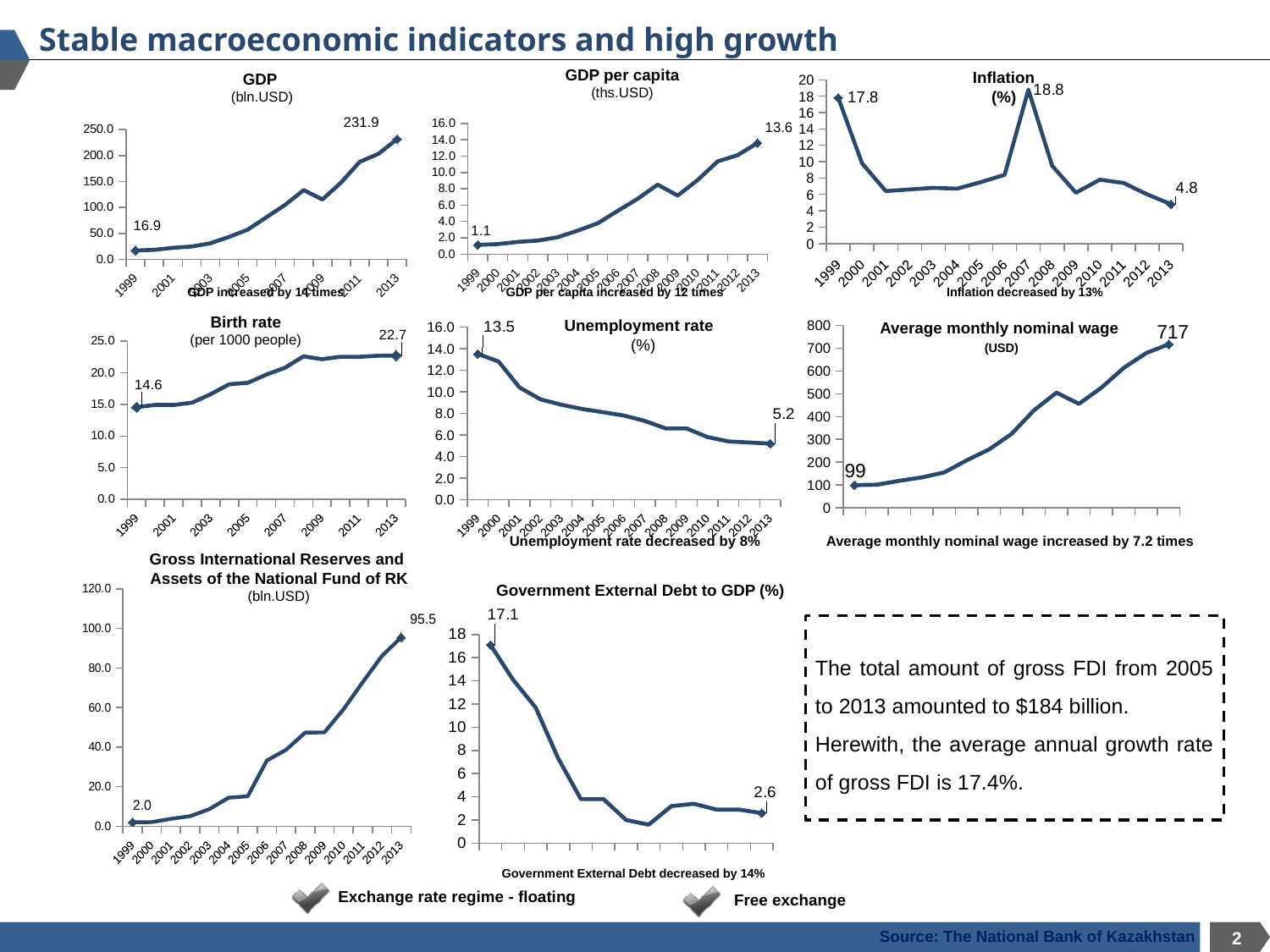
In the Unemployment rate chart, do the values generally rise or fall from 1999 to 2013? fall In the Inflation chart, which year has the highest value? 2007 In the Inflation chart, what is the difference between the 1999 value and the 2013 value? 13 In the GDP chart, what is the value for 2013? 231.9 In the Inflation chart, what is the value for 2007? 18.8 In the GDP per capita chart, what is the value for 2013? 13.6 In the GDP chart, what is the value for 1999? 16.9 In the Birth rate chart, what is the value for 1999? 14.6 What kind of chart is the Birth rate chart? line chart In the Average monthly nominal wage chart, what is the difference between the 2013 value and the 1999 value? 618 In the Government External Debt to GDP chart, what is the value for 2013? 2.6 In the Gross International Reserves chart, is the value for 2009 greater or less than 40.0? greater